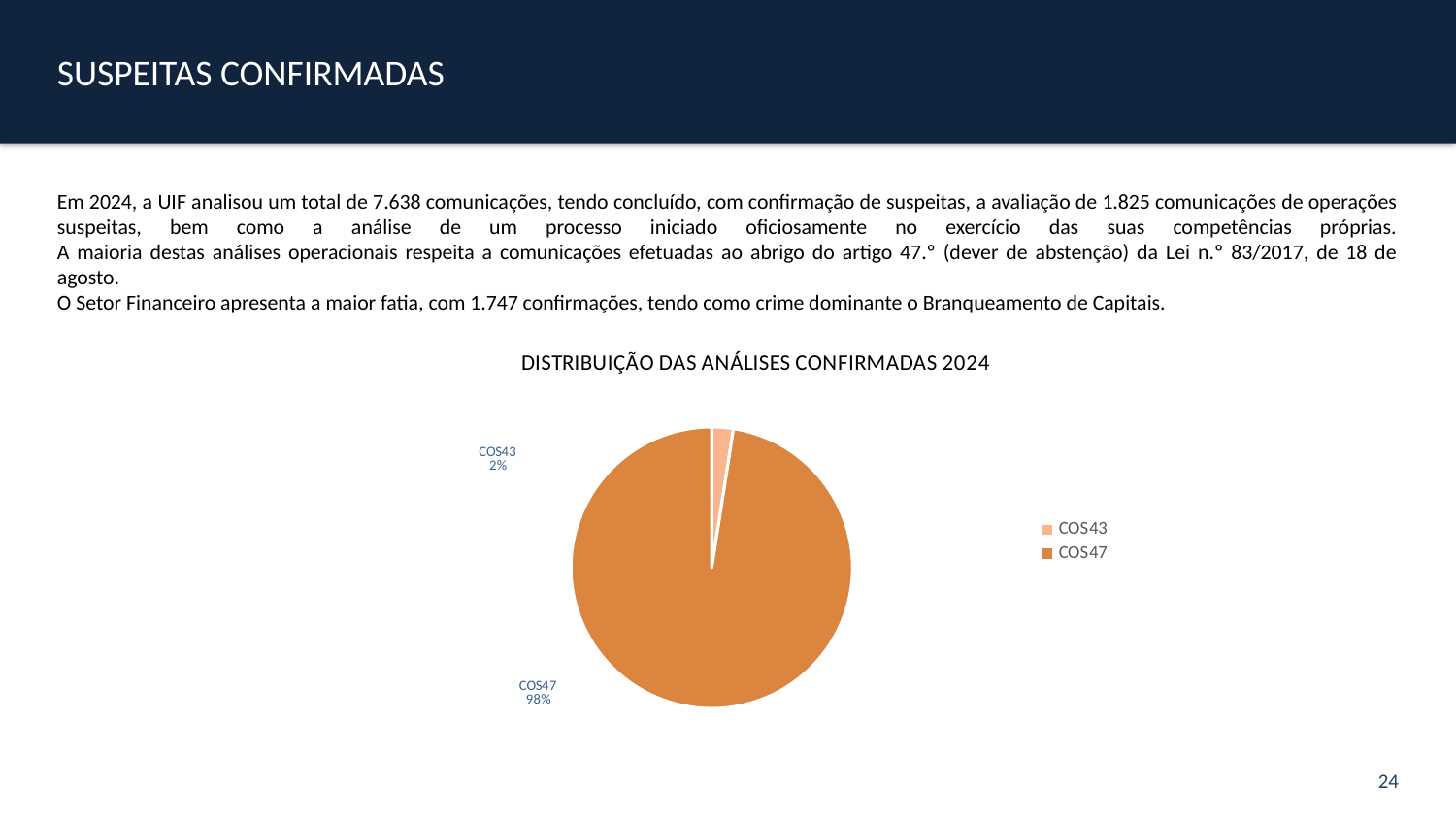
Which category has the smallest slice of the pie? COS43 What is the difference in percentage points between the COS47 and COS43 slices? 96 What share of the pie does COS43 represent? 2% Which legend entry is shown in the darker orange colour? COS47 What share of the pie does COS47 represent? 98% Which slice is larger, COS43 or COS47? COS47 Which category has the largest slice of the pie? COS47 How many entries does the legend list? 2 How many slices does the pie chart have? 2 What is the title of the chart? DISTRIBUIÇÃO DAS ANÁLISES CONFIRMADAS 2024 What kind of chart is shown on the slide? Pie chart